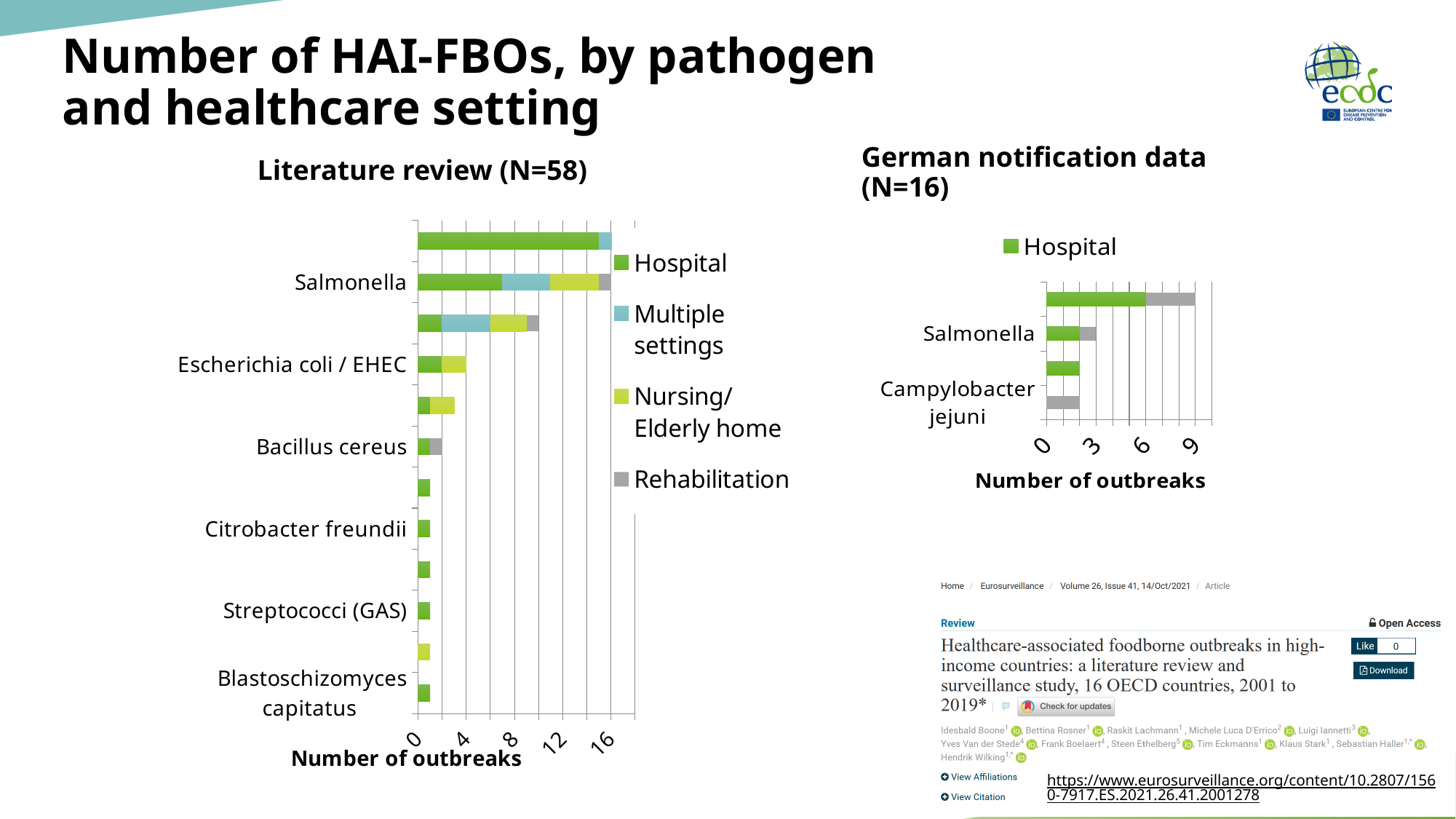
In the 'Literature review (N=58)' chart, which has more outbreaks in total, Salmonella or Escherichia coli / EHEC? Salmonella In the 'German notification data (N=16)' chart, which has more outbreaks, Salmonella or Campylobacter jejuni? Salmonella In the 'German notification data (N=16)' chart, is the number of outbreaks for Salmonella greater or less than 6? less In the 'Literature review (N=58)' chart, is the total number of outbreaks for Escherichia coli / EHEC greater or less than 8? less What kind of chart is the 'Literature review (N=58)' chart? bar chart In the 'Literature review (N=58)' chart, which has more outbreaks in total, Bacillus cereus or Streptococci (GAS)? Bacillus cereus How many series does the legend of the 'German notification data (N=16)' chart list? 1 What is the x-axis title of the 'Literature review (N=58)' chart? Number of outbreaks In the 'Literature review (N=58)' chart, is the total number of outbreaks for Salmonella greater or less than 12? greater How many series does the legend of the 'Literature review (N=58)' chart list? 4 In the 'Literature review (N=58)' chart, what are the legend entries? Hospital, Multiple settings, Nursing/Elderly home, Rehabilitation